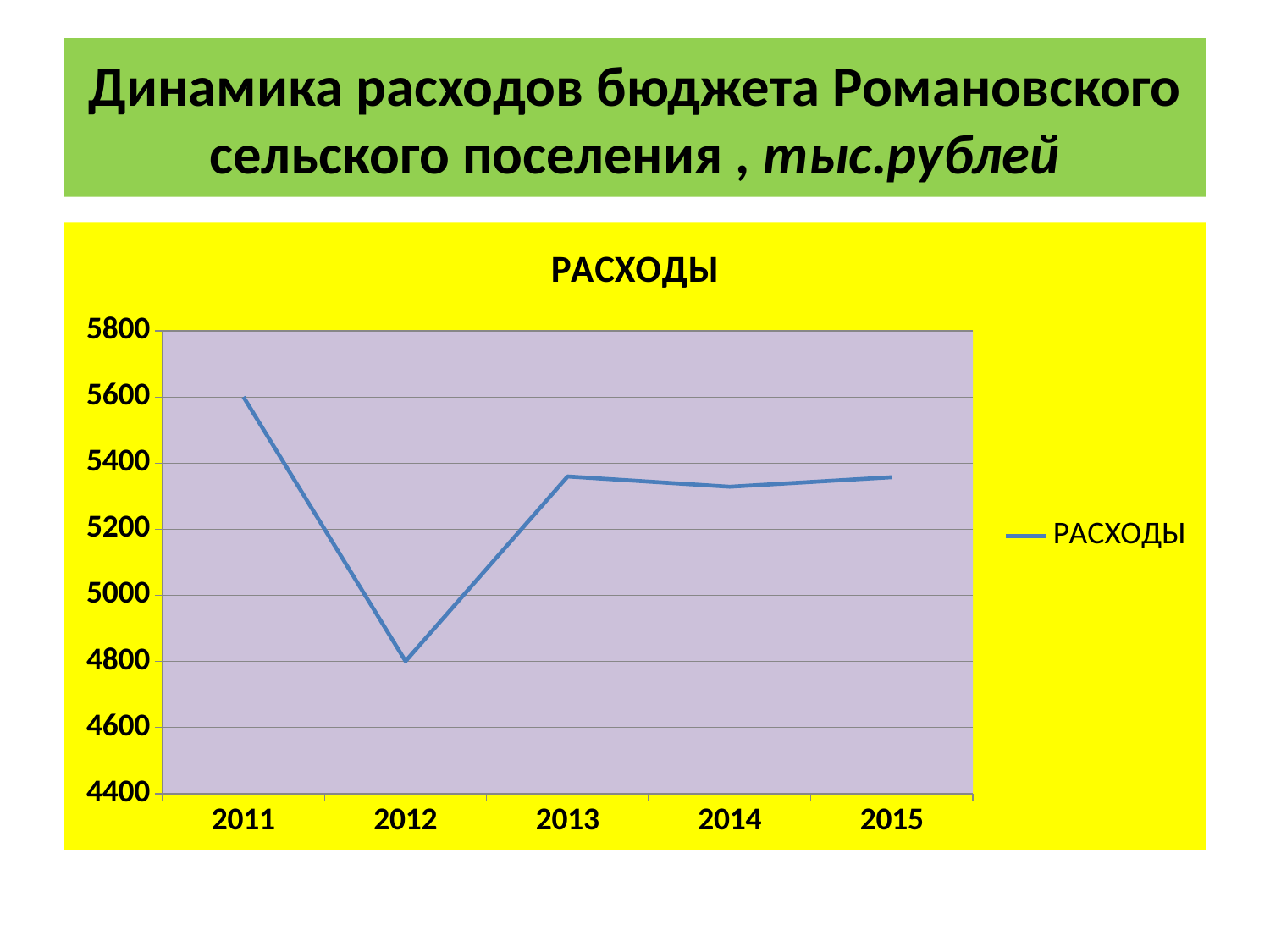
Is the value for 2014 greater or less than 5400? less Which year has the lowest value in the РАСХОДЫ chart? 2012 Which is larger, the value for 2011 or the value for 2015? 2011 Is the value for 2013 greater or less than 5200? greater Do the values rise or fall from 2012 to 2013? rise Which year has the highest value in the РАСХОДЫ chart? 2011 What is the title shown above the chart's plot area? РАСХОДЫ How many series does the legend of the chart list? 1 What kind of chart is shown on the slide? line chart How many years are plotted on the x axis of the chart? 5 Do the values rise or fall from 2011 to 2012? fall Is the value for 2012 greater or less than 5000? less